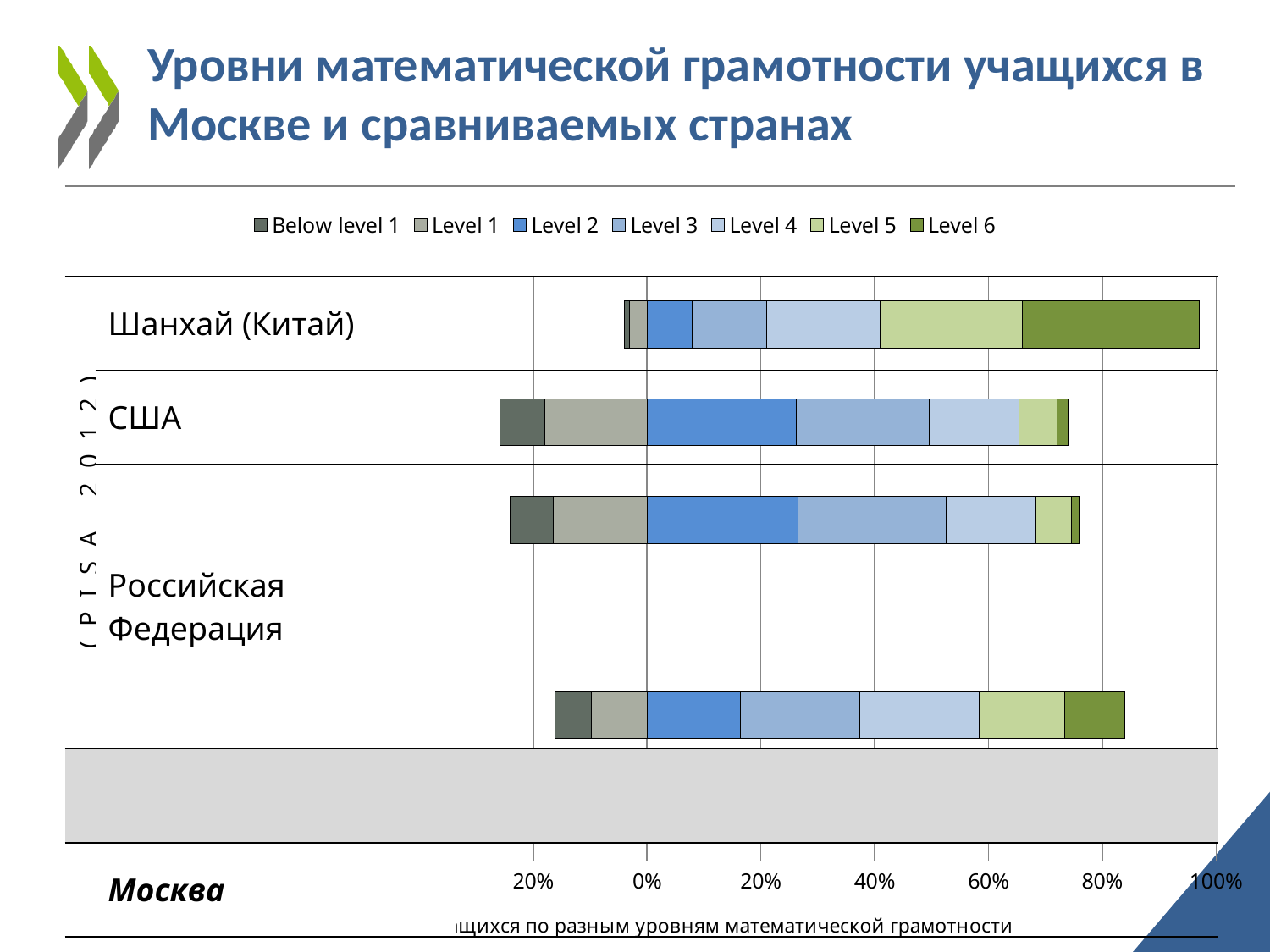
Is the Level 2 share for Шанхай (Китай) greater or less than 20%? less Which has the larger Level 6 share, Москва or США? Москва Is the Level 6 share for Шанхай (Китай) greater or less than 20%? greater Which legend entry is shown in the darkest green colour? Level 6 Which region has the largest Level 5 share? Шанхай (Китай) Is the Level 2 share for США greater or less than 20%? greater How many countries or regions are plotted in the chart? 4 What kind of chart is shown on the slide? Stacked bar chart Which has the larger Level 6 share, Шанхай (Китай) or Москва? Шанхай (Китай) Which region has the largest Level 6 share? Шанхай (Китай) How many series does the chart legend list? 7 Which region has the smallest Level 1 share? Шанхай (Китай)